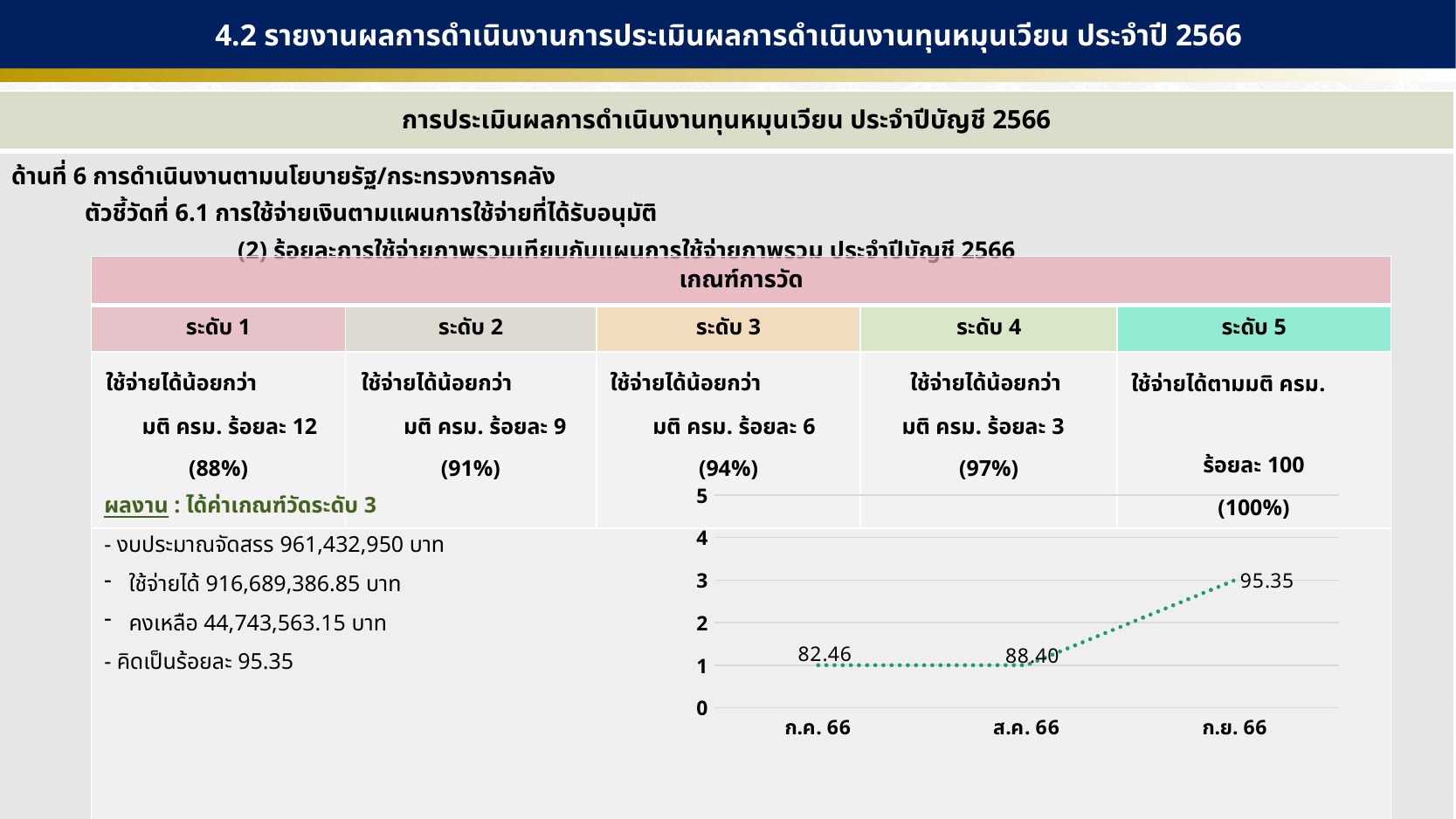
Which month has the highest data label on the line chart? ก.ย. 66 What is the highest tick value shown on the vertical axis of the line chart? 5 Do the data labels on the line chart rise or fall from ก.ค. 66 to ก.ย. 66? rise What is the data label shown for ก.ย. 66 on the line chart? 95.35 What is the difference between the data labels for ส.ค. 66 and ก.ค. 66 on the line chart? 5.94 What kind of chart is shown at the bottom right of the slide? line chart What is the data label shown for ส.ค. 66 on the line chart? 88.40 What is the difference between the data labels for ก.ย. 66 and ก.ค. 66 on the line chart? 12.89 How many data points are plotted on the line chart? 3 What is the data label shown for ก.ค. 66 on the line chart? 82.46 Which month has the lowest data label on the line chart? ก.ค. 66 Which is larger on the line chart, the data label for ส.ค. 66 or for ก.ย. 66? ก.ย. 66